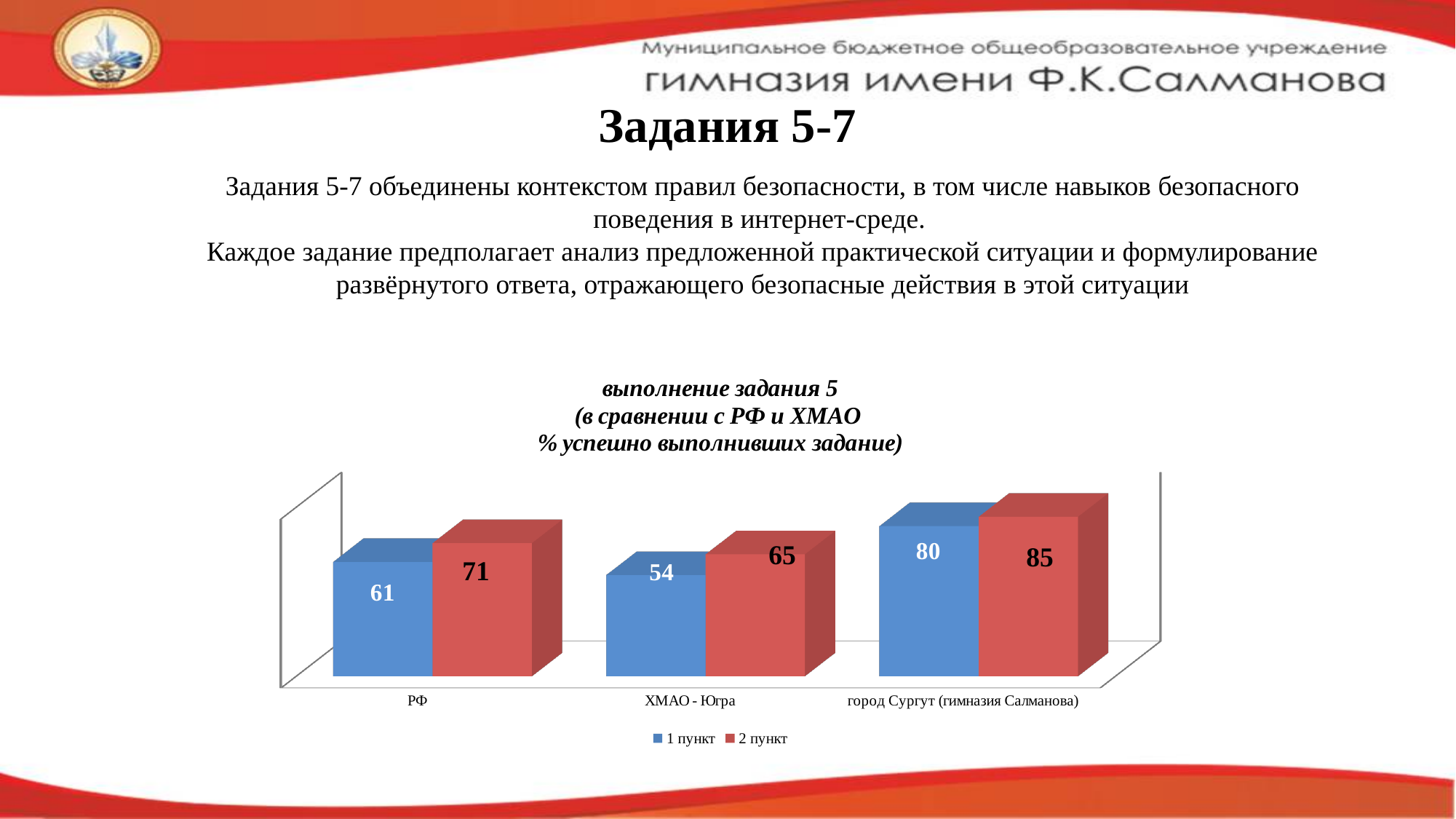
What is the value of "1 пункт" for город Сургут (гимназия Салманова)? 80 What is the value of "1 пункт" for РФ? 61 Which category has the highest value for "2 пункт"? город Сургут (гимназия Салманова) How many categories are shown on the x axis? 3 What is the value of "2 пункт" for ХМАО - Югра? 65 What is the value of "2 пункт" for город Сургут (гимназия Салманова)? 85 What kind of chart is shown on the slide? Bar chart What is the difference between "2 пункт" and "1 пункт" for РФ? 10 Which category has the lowest value for "1 пункт"? ХМАО - Югра Which is larger: "1 пункт" for город Сургут (гимназия Салманова) or "2 пункт" for РФ? 1 пункт for город Сургут (гимназия Салманова) What colour are the bars for the "2 пункт" series? Red How many series does the legend list? 2